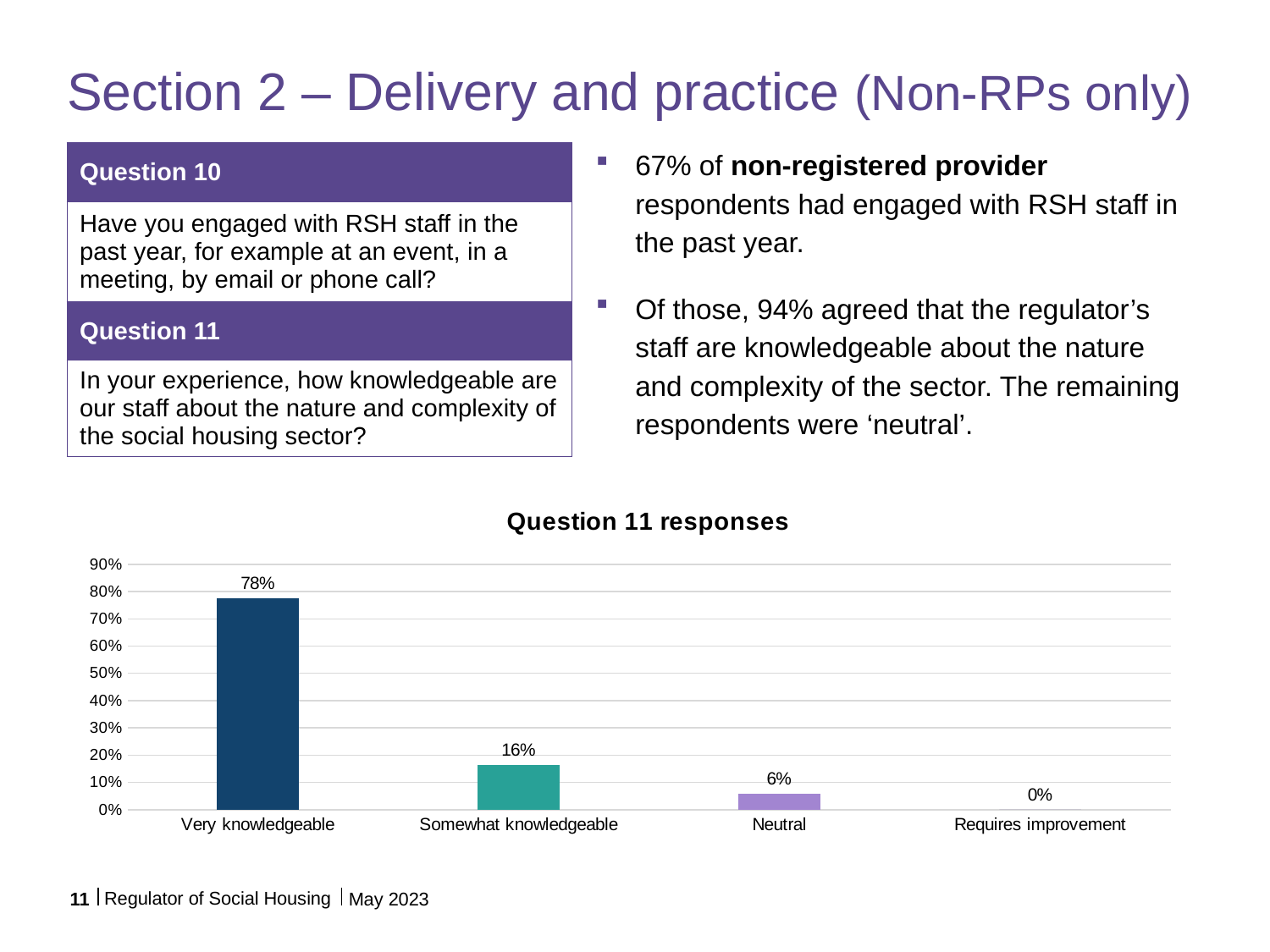
Is the value for Very knowledgeable greater or less than 70%? greater Which is larger, the value for Somewhat knowledgeable or the value for Neutral? Somewhat knowledgeable What is the title of the chart? Question 11 responses What is the value for Very knowledgeable? 78% What kind of chart is shown on the slide? bar chart Which category has the highest value? Very knowledgeable What is the value for Requires improvement? 0% Which category has the lowest value? Requires improvement What is the difference between the values for Very knowledgeable and Somewhat knowledgeable? 62% What is the value for Somewhat knowledgeable? 16% What is the value for Neutral? 6% How many categories are shown on the x axis? 4